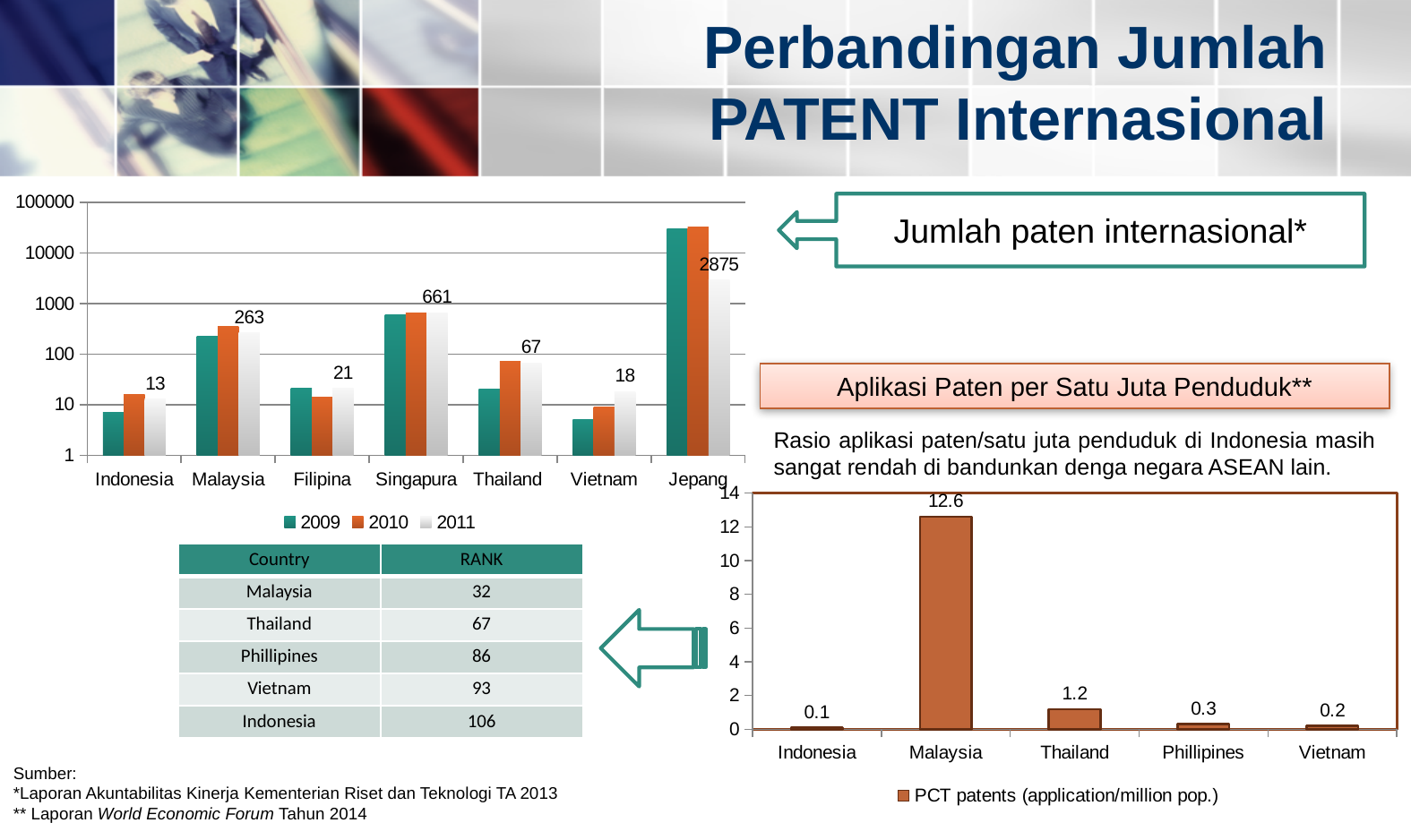
In the bottom-right chart (PCT patents per million population), which country has the highest value? Malaysia In the top-left chart, which has the larger labelled 2011 value, Malaysia or Thailand? Malaysia What are the legend entries of the top-left chart? 2009, 2010, 2011 How many countries are shown on the x axis of the top-left chart? 7 How many countries are shown in the bottom-right chart (PCT patents per million population)? 5 What kind of chart is the bottom-right chart (PCT patents per million population)? Bar chart How many series does the legend of the top-left chart list? 3 In the bottom-right chart (PCT patents per million population), what is the difference between the values for Malaysia and Thailand? 11.4 In the bottom-right chart (PCT patents per million population), what is the value for Malaysia? 12.6 In the bottom-right chart (PCT patents per million population), which country has the lowest value? Indonesia In the top-left chart, is the 2009 value for Jepang greater or less than 10000? greater In the top-left chart, what is the labelled 2011 value for Singapura? 661